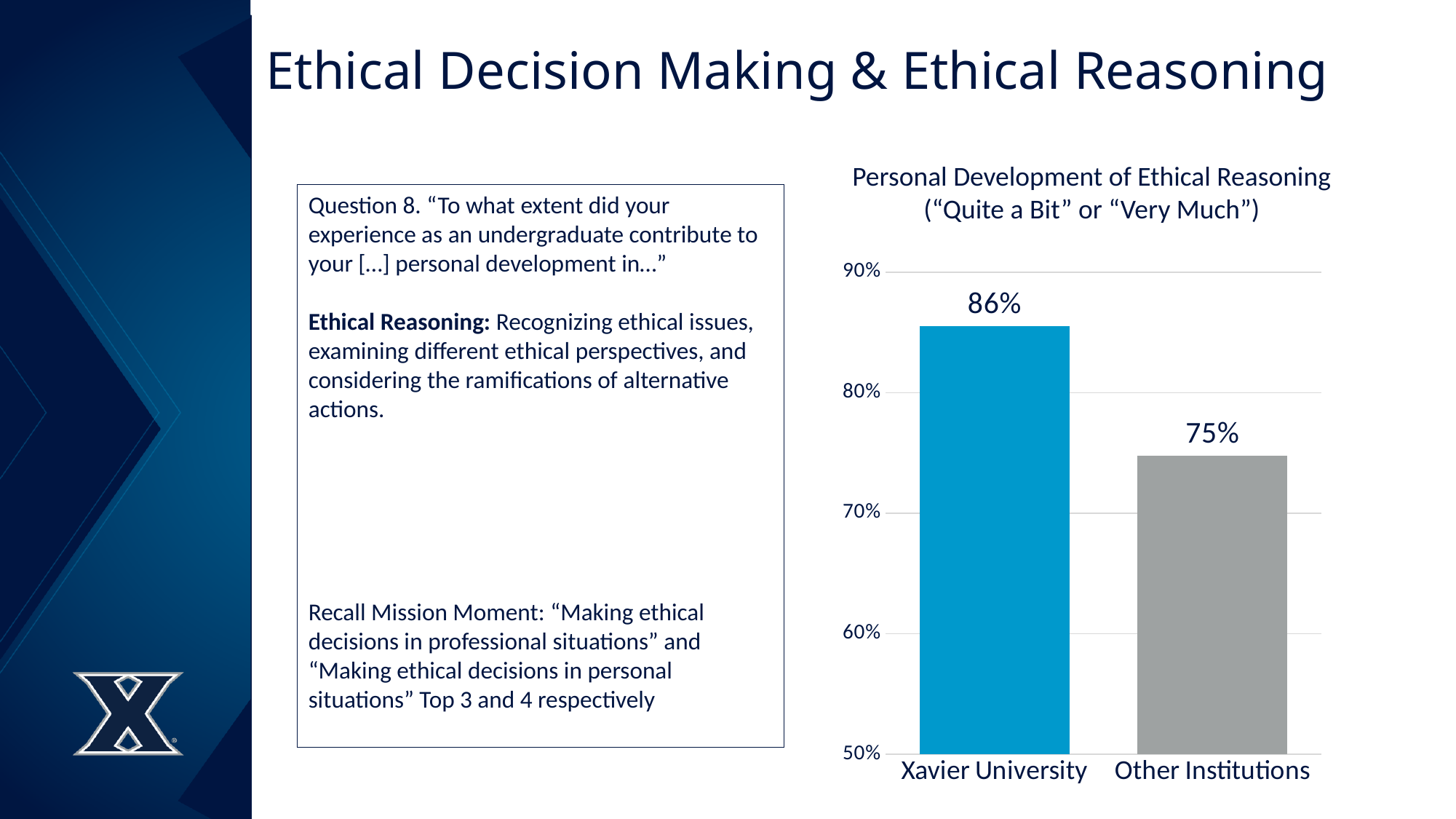
What is the difference between the values for Xavier University and Other Institutions? 11% What kind of chart is shown on the slide? bar chart Which is larger, the value for Xavier University or the value for Other Institutions? Xavier University Which category has the highest value? Xavier University Is the value for Other Institutions greater or less than 80%? less What colour is the bar for Xavier University? blue Is the value for Xavier University greater or less than 80%? greater What is the title of the chart? Personal Development of Ethical Reasoning ("Quite a Bit" or "Very Much") Which category has the lowest value? Other Institutions What is the value for Xavier University? 86% What is the value for Other Institutions? 75% How many categories are shown in the chart? 2